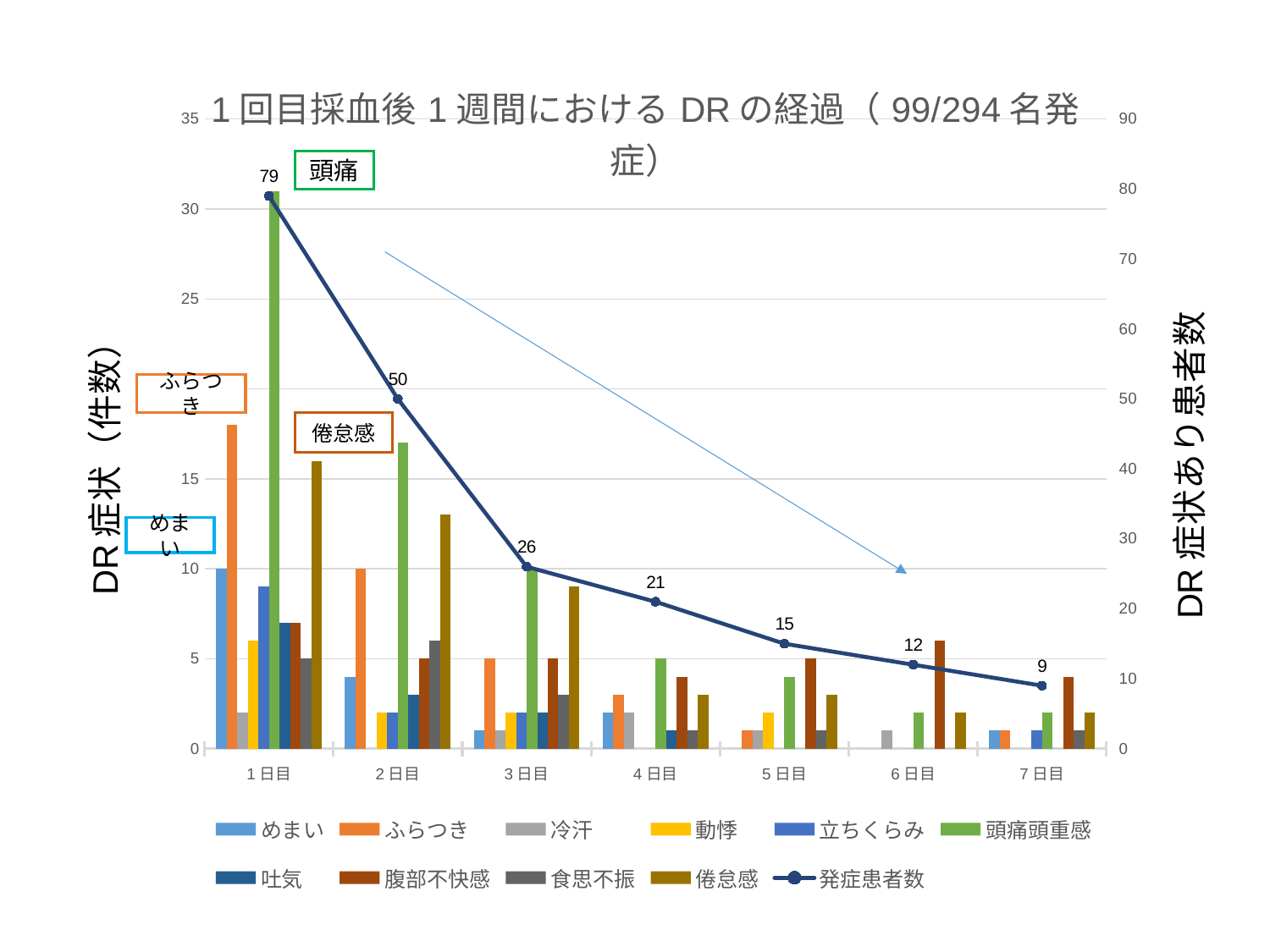
Does 発症患者数 rise or fall from 1日目 to 7日目? fall How many days are shown on the x axis? 7 What is the difference in 発症患者数 between 3日目 and 4日目? 5 On which day is 発症患者数 lowest? 7日目 On which day is 発症患者数 highest? 1日目 Which day has a larger 発症患者数, 5日目 or 6日目? 5日目 How many series does the legend list? 11 What is the value of 発症患者数 on 3日目? 26 What is the value of 発症患者数 on 7日目? 9 What is the value of 発症患者数 on 1日目? 79 What is the difference in 発症患者数 between 1日目 and 2日目? 29 Is the value for 頭痛頭重感 on 1日目 greater or less than 25 on the left axis? greater